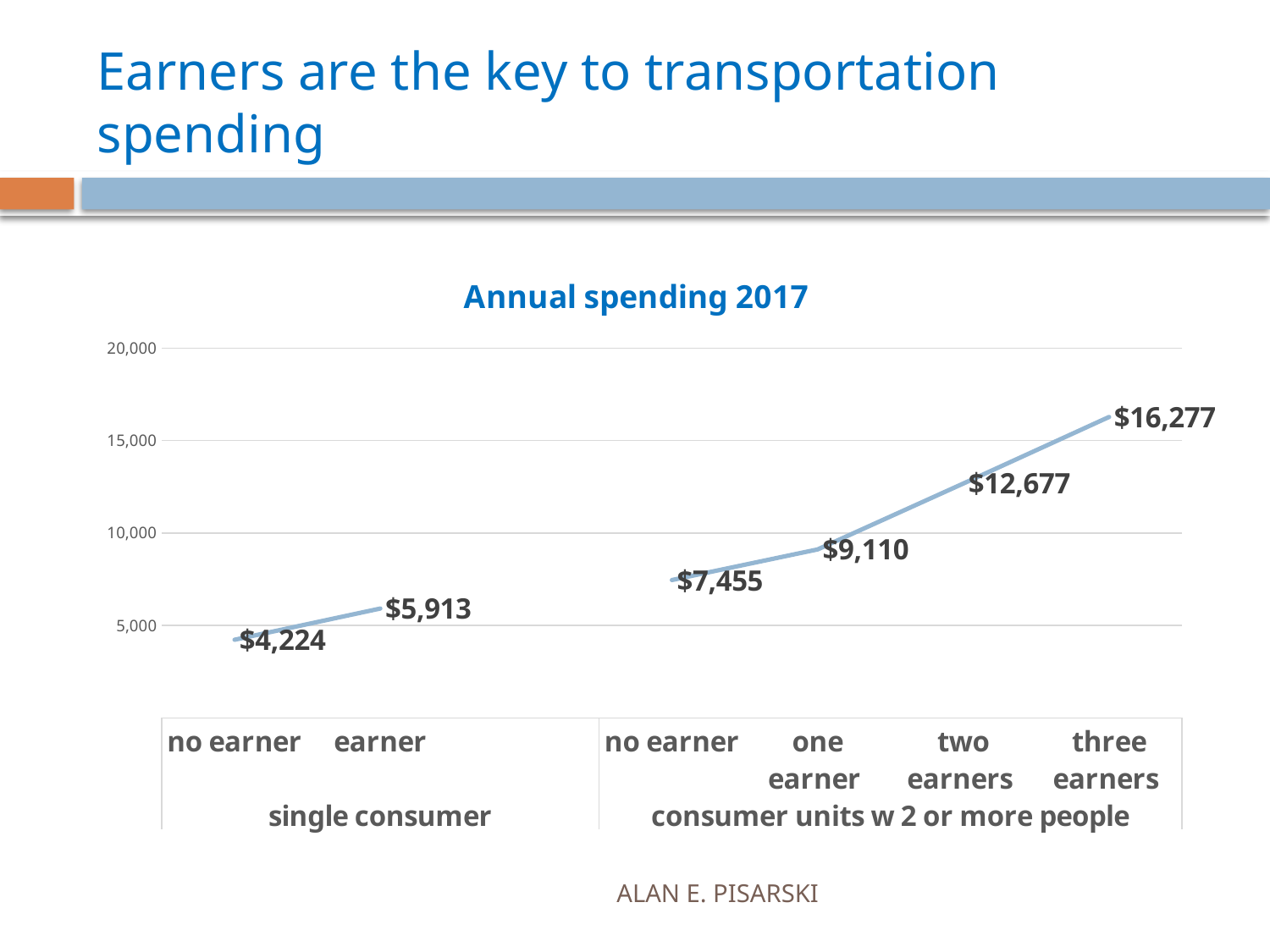
What is the difference in annual spending between three earners and two earners among consumer units with 2 or more people? $3,600 What is the difference in annual spending between a single consumer with an earner and a single consumer with no earner? $1,689 Which is larger: annual spending for a single consumer with an earner, or for a consumer unit with 2 or more people and no earner? consumer unit with 2 or more people and no earner What kind of chart is shown on the slide? line chart What is the annual spending for consumer units with 2 or more people and three earners? $16,277 Is the annual spending for two earners (consumer units w 2 or more people) greater or less than 10,000? greater What is the title of the chart? Annual spending 2017 What is the annual spending for consumer units with 2 or more people and one earner? $9,110 Which category has the lowest annual spending? no earner (single consumer) What is the annual spending for a single consumer with no earner? $4,224 How many categories are plotted on the chart? 6 Which category has the highest annual spending? three earners (consumer units w 2 or more people)